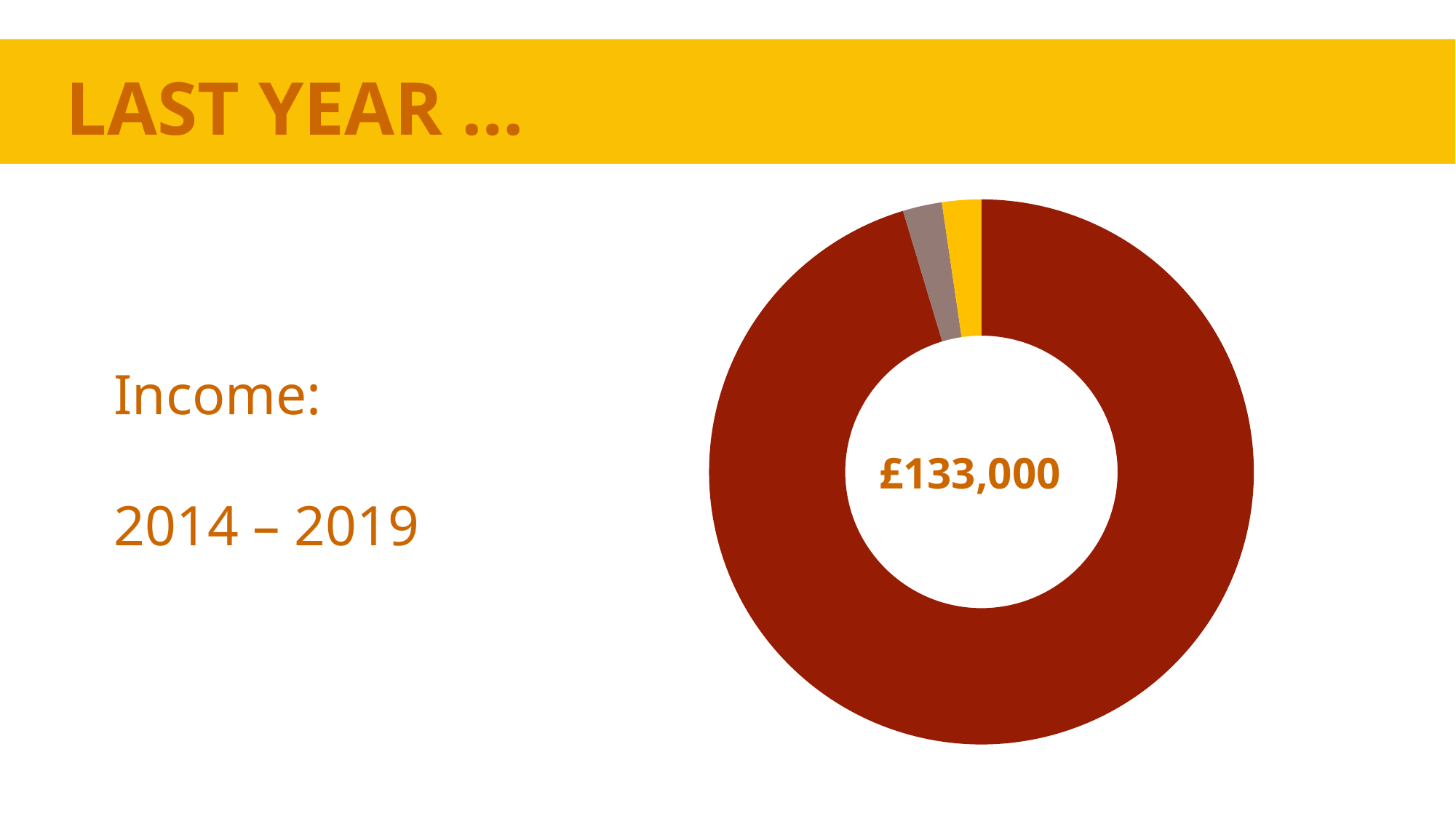
What period does the income shown on the slide cover? 2014 – 2019 What value is printed in the centre of the doughnut chart? £133,000 What kind of chart is shown on the slide? Doughnut (pie) chart How many slices does the doughnut chart have? 3 Does the dark red slice account for more or less than half of the doughnut chart? More Which colour slice is the largest in the doughnut chart? Dark red Is the dark red slice larger or smaller than the yellow slice? Larger What is the title of the slide containing the doughnut chart? LAST YEAR ...